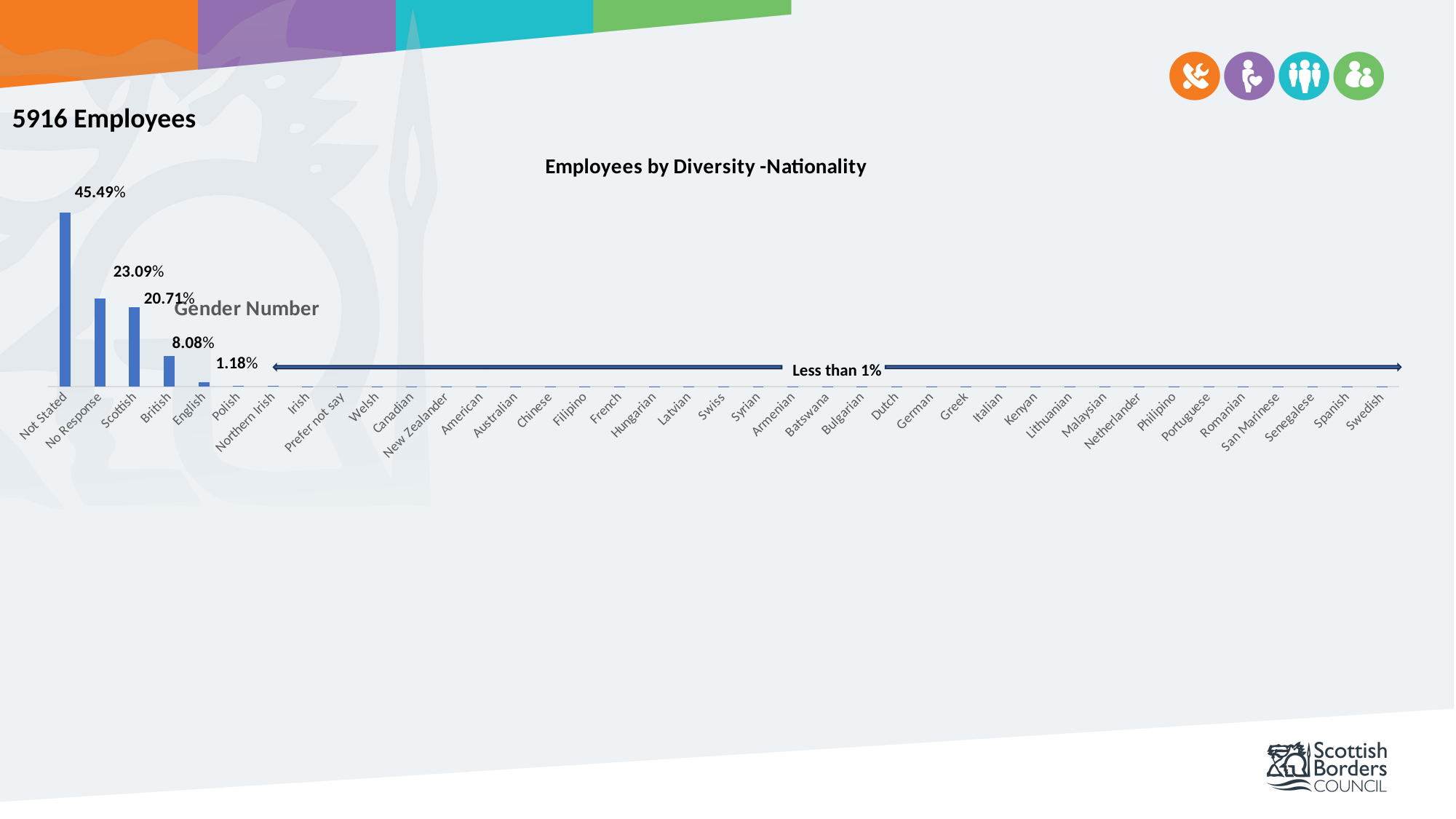
What is the difference between the values for Not Stated and No Response? 22.40 percentage points What does the arrow label say about the nationalities from Polish onwards? Less than 1% What percentage of employees is shown for English? 1.18% What percentage of employees is shown for Scottish? 20.71% What is the title of the chart? Employees by Diversity -Nationality What percentage of employees is shown for Not Stated? 45.49% What kind of chart is shown on the slide? bar chart Which is larger, the value for Scottish or the value for British? Scottish Which category has the highest value in the chart? Not Stated What is the difference between the values for Scottish and British? 12.63 percentage points What percentage of employees is shown for British? 8.08% What percentage of employees is shown for No Response? 23.09%